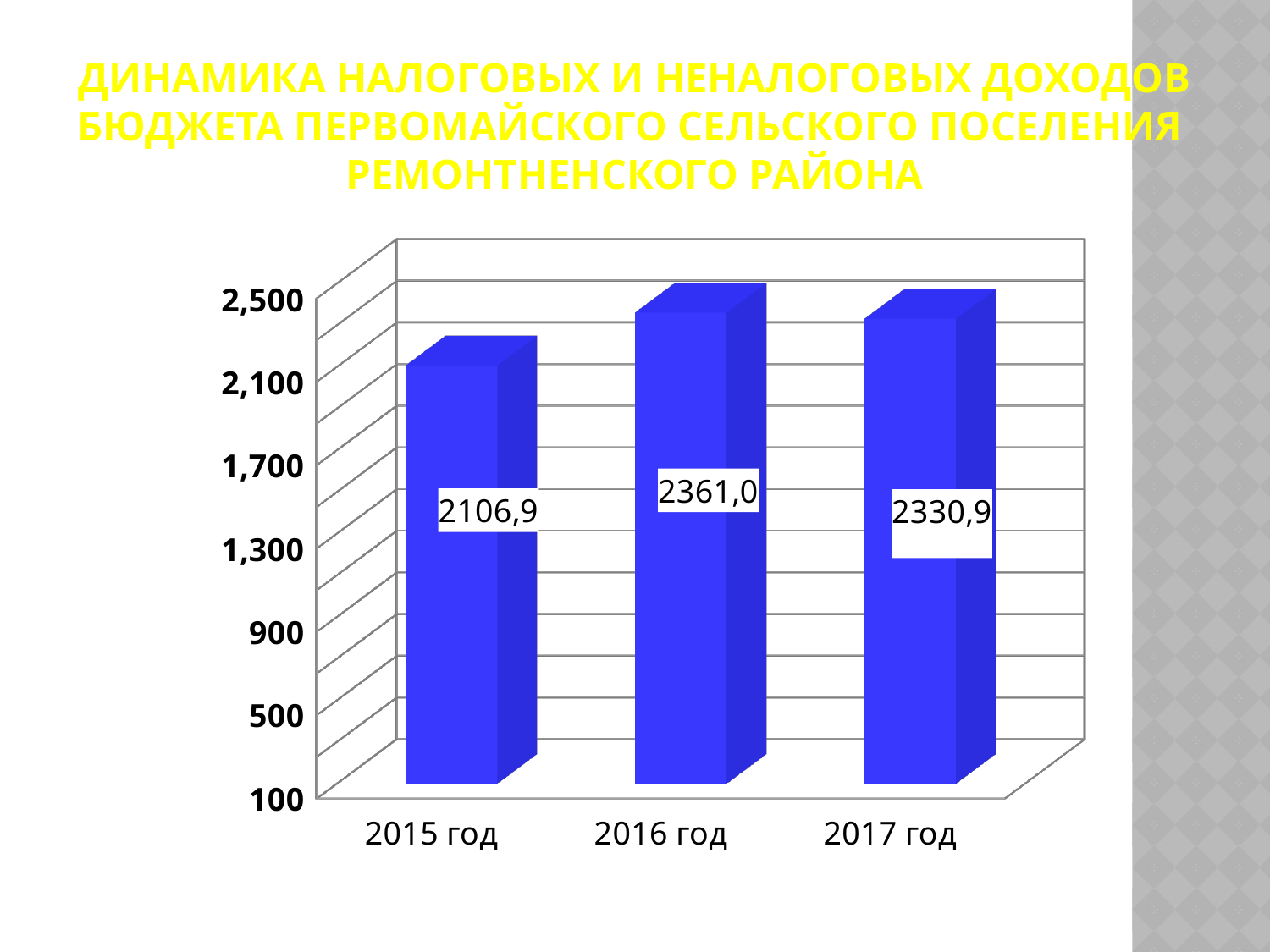
What is the difference between the values for 2016 год and 2015 год? 254,1 Do the values rise or fall from 2016 год to 2017 год? fall What is the value for 2015 год? 2106,9 Which year has the highest value? 2016 год What is the difference between the values for 2016 год and 2017 год? 30,1 What is the value for 2016 год? 2361,0 Is the value for 2015 год greater or less than 1,700? greater Which year has the lowest value? 2015 год How many years are shown on the x axis? 3 What kind of chart is shown on the slide? bar chart What is the value for 2017 год? 2330,9 Which is larger, the value for 2017 год or the value for 2015 год? 2017 год